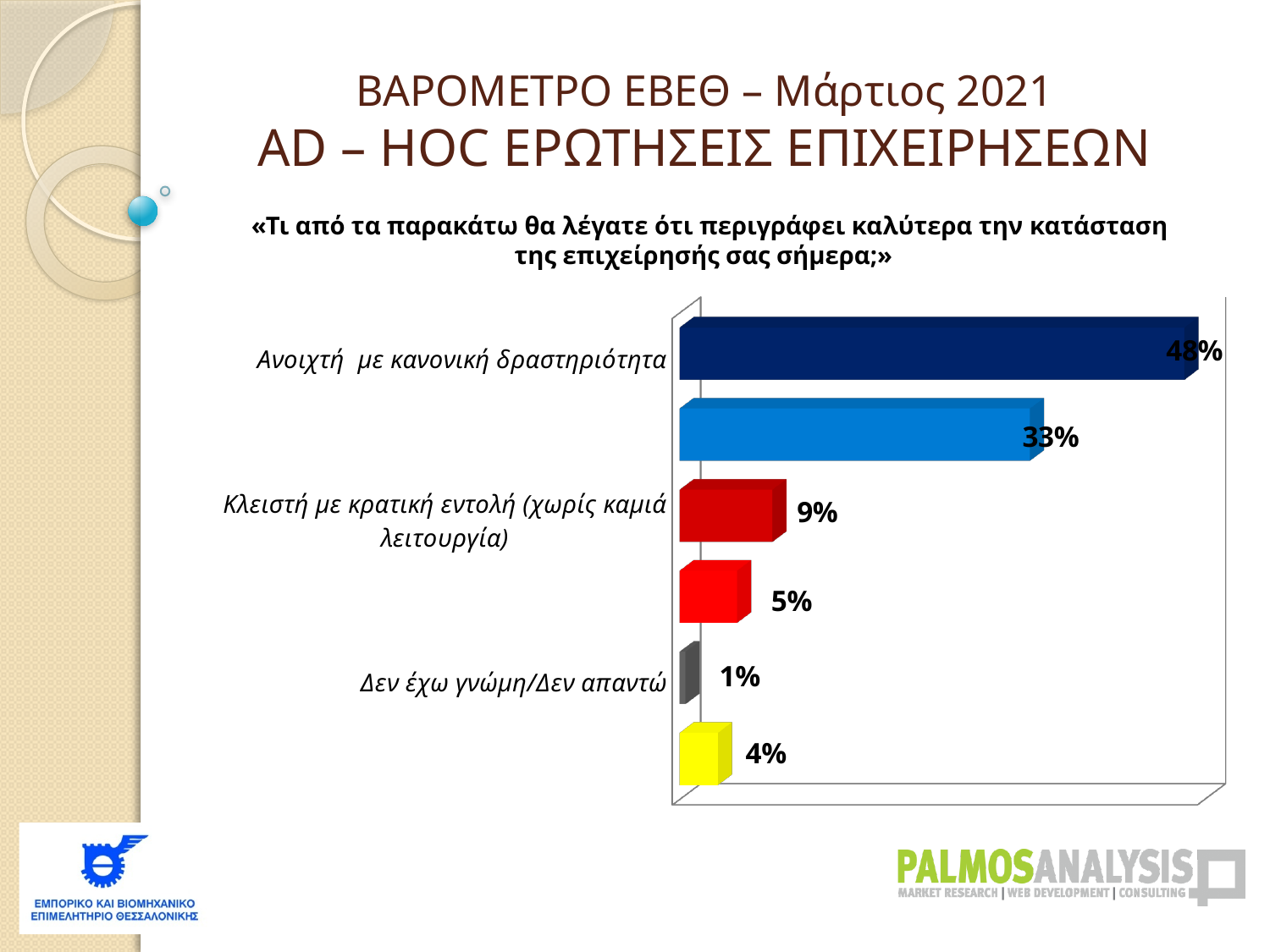
Which labelled category has the lowest value? Δεν έχω γνώμη/Δεν απαντώ What value is printed on the bottom (yellow) bar? 4% What value is printed on the second bar from the top? 33% What percentage of businesses answered "Ανοιχτή με κανονική δραστηριότητα"? 48% What percentage is shown for "Κλειστή με κρατική εντολή (χωρίς καμιά λειτουργία)"? 9% How many bars are plotted in the chart? 6 What type of chart is shown on the slide? Bar chart What is the month and year given in the slide title? Μάρτιος 2021 What percentage is shown for "Δεν έχω γνώμη/Δεν απαντώ"? 1% What is the difference in percentage points between "Ανοιχτή με κανονική δραστηριότητα" and "Κλειστή με κρατική εντολή (χωρίς καμιά λειτουργία)"? 39 percentage points Which is larger: the value for "Κλειστή με κρατική εντολή (χωρίς καμιά λειτουργία)" or the value for "Δεν έχω γνώμη/Δεν απαντώ"? Κλειστή με κρατική εντολή (χωρίς καμιά λειτουργία) Which labelled category has the highest value? Ανοιχτή με κανονική δραστηριότητα